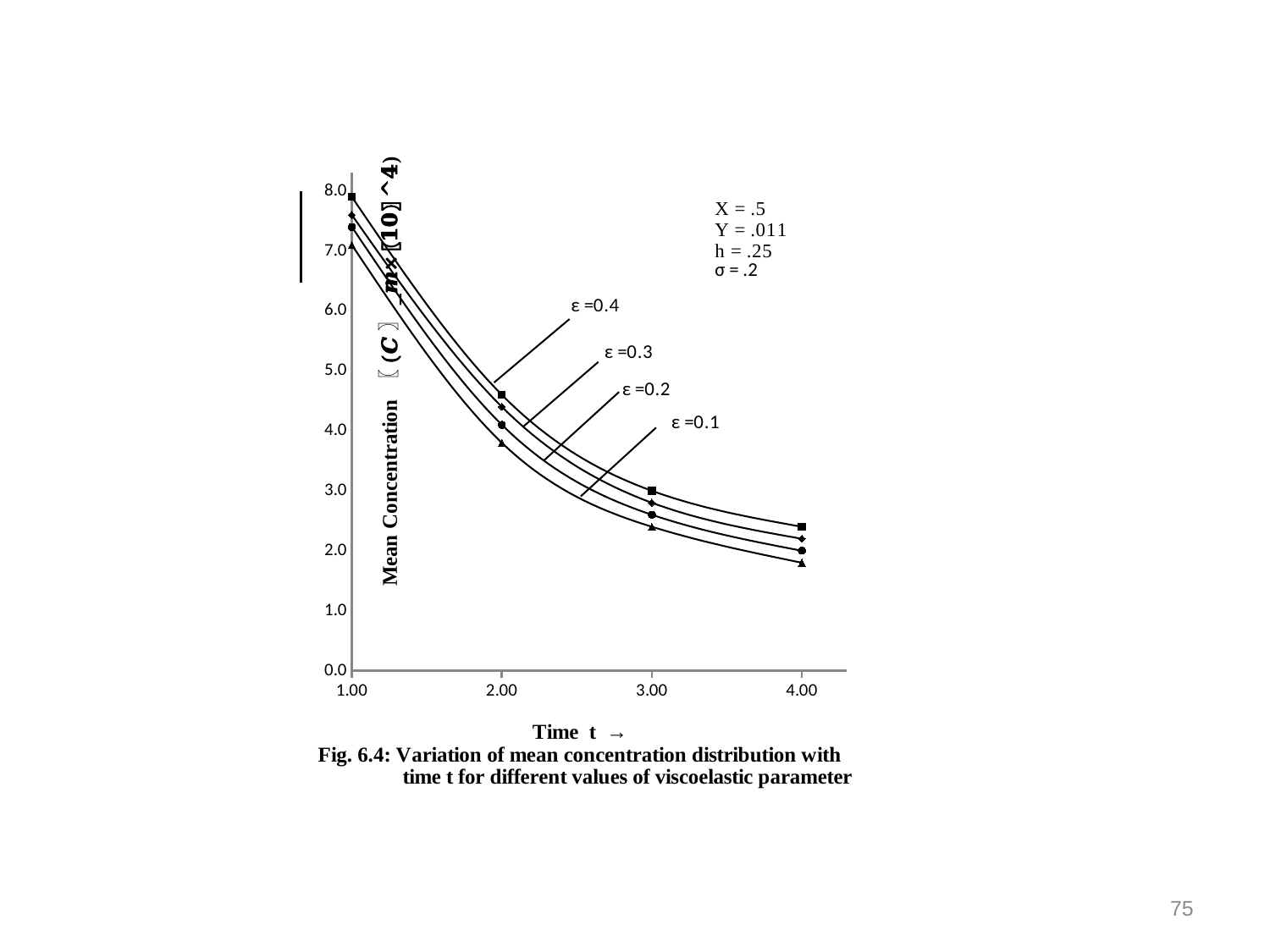
Which curve has the highest mean concentration at every time point? ε =0.4 Do the mean concentration values rise or fall as time t increases? fall What value of h is stated in the parameter box on the chart? h = .25 Is the value for ε =0.1 at time t = 4.00 greater or less than 2.0? less At time t = 2.00, which curve is higher, ε =0.4 or ε =0.1? ε =0.4 Is the value for ε =0.1 at time t = 3.00 greater or less than 3.0? less Is the value for ε =0.4 at time t = 2.00 greater or less than 4.0? greater How many curves (values of ε) are plotted on the chart? 4 How many time points are marked along the x axis? 4 Which curve has the lowest mean concentration at every time point? ε =0.1 What kind of chart is shown on the slide? line chart What is the figure number given in the caption of the chart? Fig. 6.4